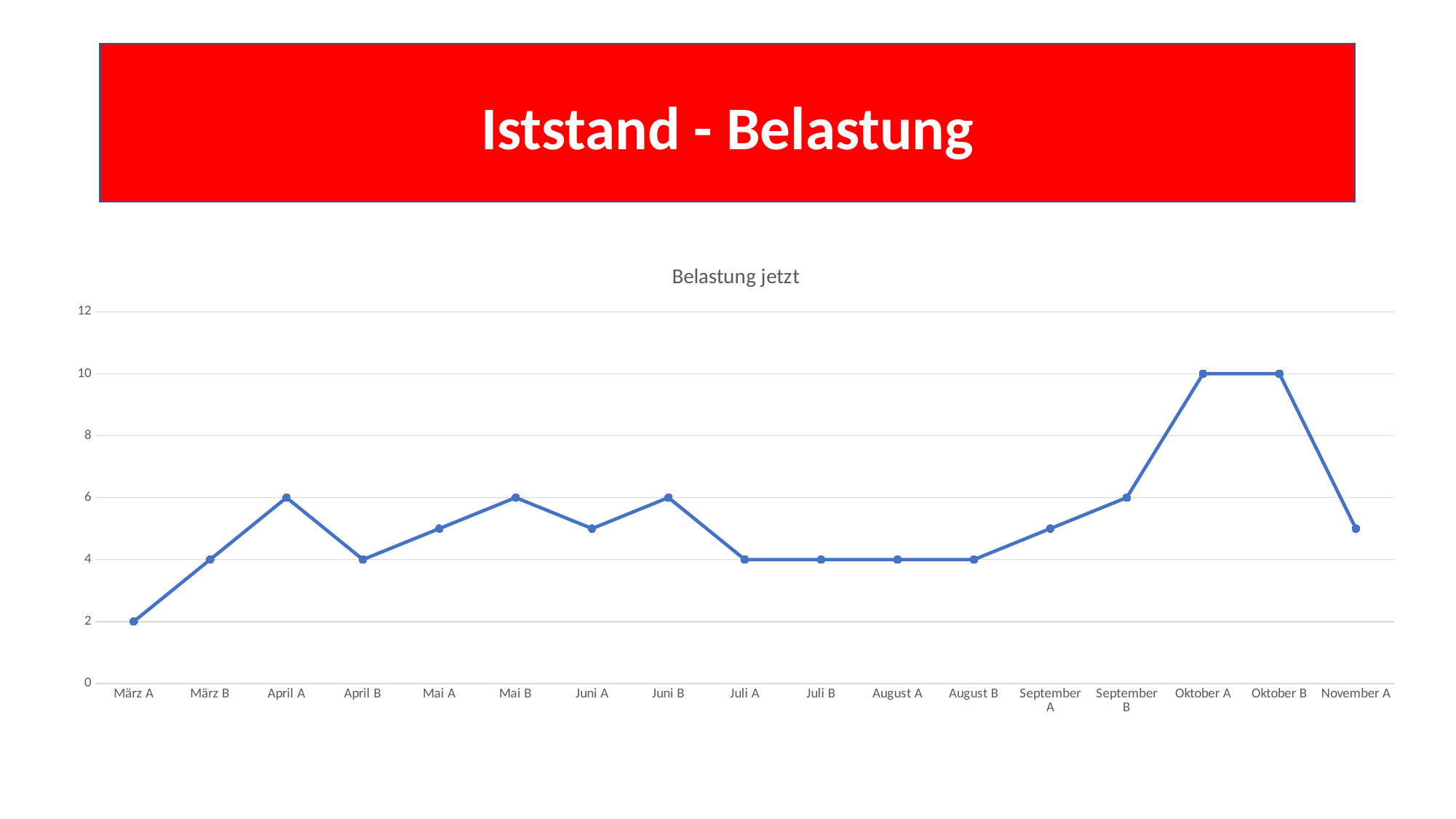
Which category has the lowest value? März A How many categories are shown on the x axis? 17 Which has the larger value, April A or April B? April A What is the title of the chart? Belastung jetzt What type of chart is shown on the slide? line chart What is the value for Juli B? 4 What is the value for April A? 6 What is the highest value reached on the chart? 10 What is the value for Oktober A? 10 What is the difference between the values for Oktober B and März A? 8 What is the value for März A? 2 Is the value for Mai A greater or less than 4? greater